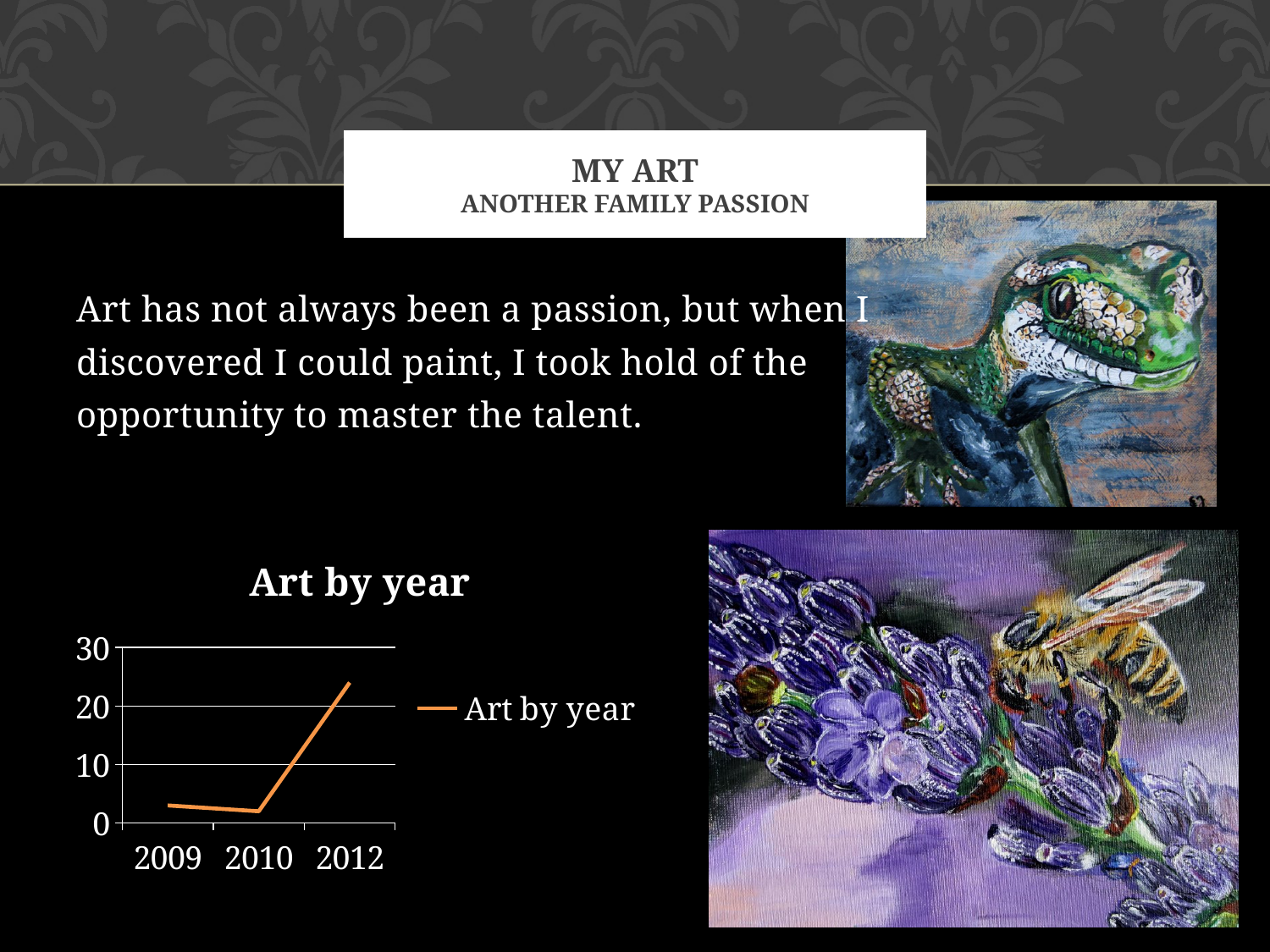
Which is larger, the value for 2012 or the value for 2010? 2012 Is the value for 2010 greater or less than 10? less Does the value rise or fall between 2010 and 2012? rise Is the value for 2012 greater or less than 20? greater What is the highest value shown on the y axis of the chart? 30 How many series does the chart legend list? 1 What kind of chart is shown on the slide? line chart Which year has the highest value in the chart? 2012 How many years are plotted on the x axis of the chart? 3 What is the title of the chart? Art by year Is the value for 2009 greater or less than 10? less